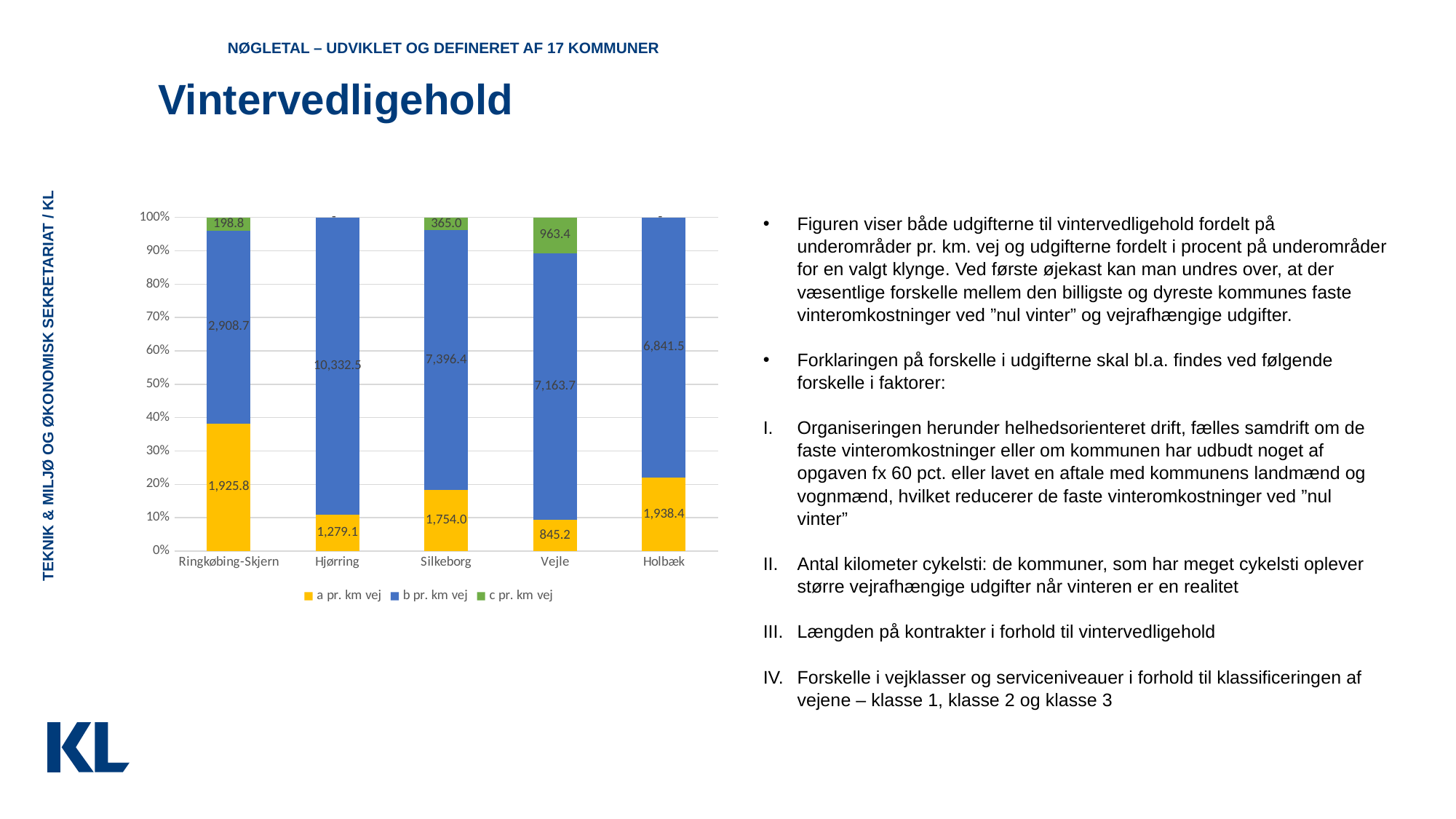
What is the value of 'a pr. km vej' for Vejle? 845.2 Which municipality has the highest value for 'b pr. km vej'? Hjørring What is the total of the three labelled values in the Silkeborg bar? 9,515.4 How many series does the legend list? 3 Which municipality has the highest value for 'c pr. km vej'? Vejle What is the difference between the 'a pr. km vej' values for Holbæk and Ringkøbing-Skjern? 12.6 Which municipality has the lowest value for 'a pr. km vej'? Vejle How many municipalities are shown on the x axis? 5 What is the value of 'b pr. km vej' for Hjørring? 10,332.5 What is the value of 'c pr. km vej' for Silkeborg? 365.0 Which is larger: 'b pr. km vej' for Silkeborg or for Vejle? Silkeborg Is the share of 'a pr. km vej' in the Ringkøbing-Skjern bar greater or less than 30%? greater